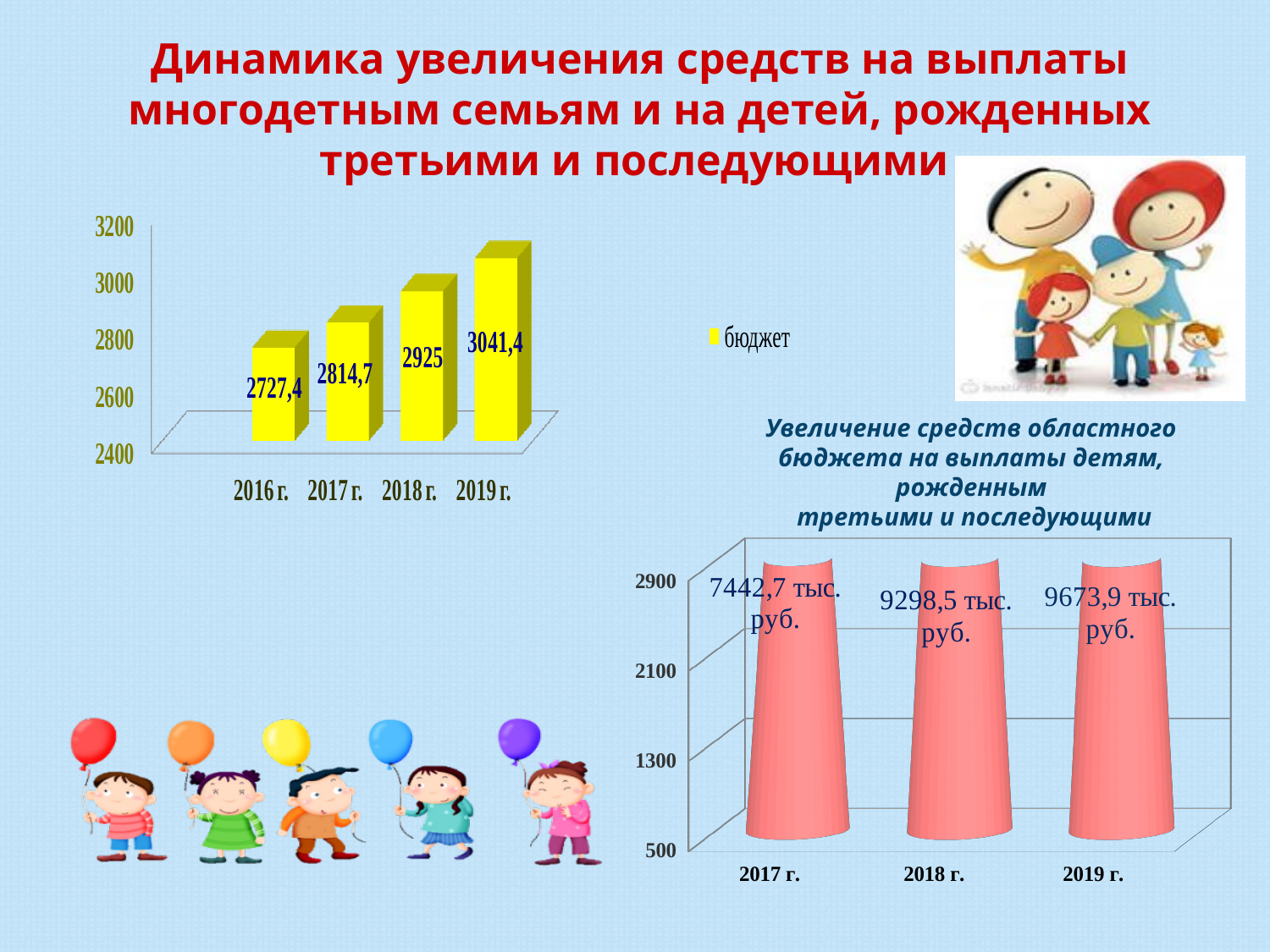
In the chart titled 'Увеличение средств областного бюджета на выплаты детям, рожденным третьими и последующими', what is the difference between the values for 2018 г. and 2017 г.? 1855,8 тыс. руб. In the left chart (yellow bars), which year has the highest value? 2019 г. In the left chart (yellow bars), which year has the lowest value? 2016 г. In the chart titled 'Увеличение средств областного бюджета на выплаты детям, рожденным третьими и последующими', what is the value for 2019 г.? 9673,9 тыс. руб. In the left chart (yellow bars), how many years are shown? 4 In the left chart (yellow bars), what is the value for 2018 г.? 2925 In the left chart (yellow bars), what is the legend entry? бюджет In the left chart (yellow bars), do the values rise or fall from 2016 г. to 2019 г.? rise In the chart titled 'Увеличение средств областного бюджета на выплаты детям, рожденным третьими и последующими', what is the value for 2017 г.? 7442,7 тыс. руб. In the left chart (yellow bars), what is the value for 2016 г.? 2727,4 In the chart titled 'Увеличение средств областного бюджета на выплаты детям, рожденным третьими и последующими', how many years are shown? 3 In the left chart (yellow bars), what is the difference between the values for 2019 г. and 2016 г.? 314